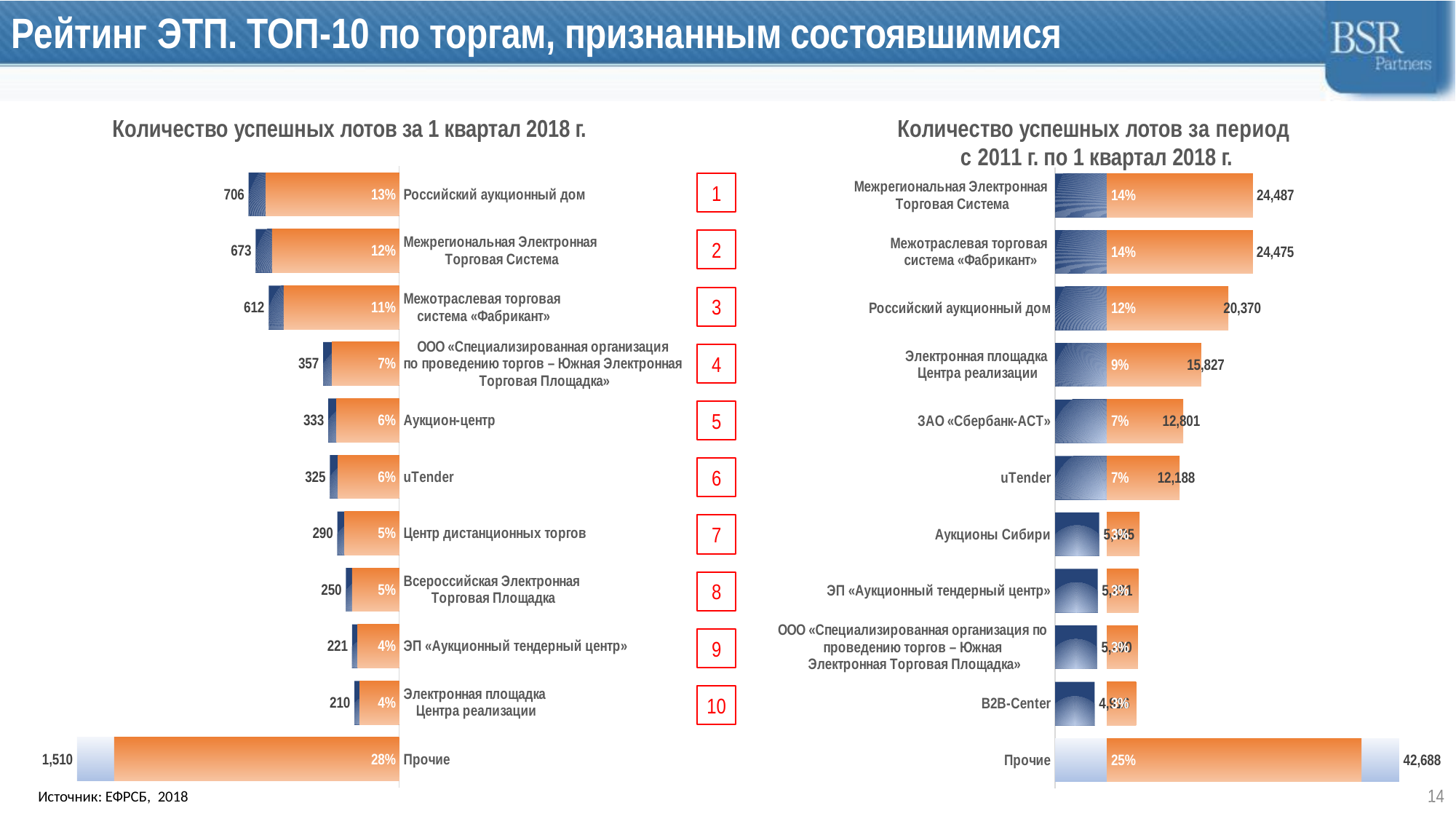
In the left chart (Количество успешных лотов за 1 квартал 2018 г.), what is the value for Российский аукционный дом? 706 In the right chart (Количество успешных лотов за период с 2011 г. по 1 квартал 2018 г.), what is the difference between Межрегиональная Электронная Торговая Система and Межотраслевая торговая система «Фабрикант»? 12 In the right chart (Количество успешных лотов за период с 2011 г. по 1 квартал 2018 г.), what is the value for Российский аукционный дом? 20,370 In the left chart (Количество успешных лотов за 1 квартал 2018 г.), what percentage is shown for Прочие? 28% In the left chart (Количество успешных лотов за 1 квартал 2018 г.), which is larger: Центр дистанционных торгов or Всероссийская Электронная Торговая Площадка? Центр дистанционных торгов In the left chart (Количество успешных лотов за 1 квартал 2018 г.), what is the value for Аукцион-центр? 333 What type of chart is used on the left side of the slide? Bar chart In the right chart (Количество успешных лотов за период с 2011 г. по 1 квартал 2018 г.), which is larger: ЗАО «Сбербанк-АСТ» or uTender? ЗАО «Сбербанк-АСТ» In the right chart (Количество успешных лотов за период с 2011 г. по 1 квартал 2018 г.), what is the value for Прочие? 42,688 In the left chart (Количество успешных лотов за 1 квартал 2018 г.), what is the difference between Российский аукционный дом and Межрегиональная Электронная Торговая Система? 33 In the left chart (Количество успешных лотов за 1 квартал 2018 г.), which category has the lowest value among the ranked top-10 platforms? Электронная площадка Центра реализации How many categories (bars) are shown in the left chart (Количество успешных лотов за 1 квартал 2018 г.)? 11